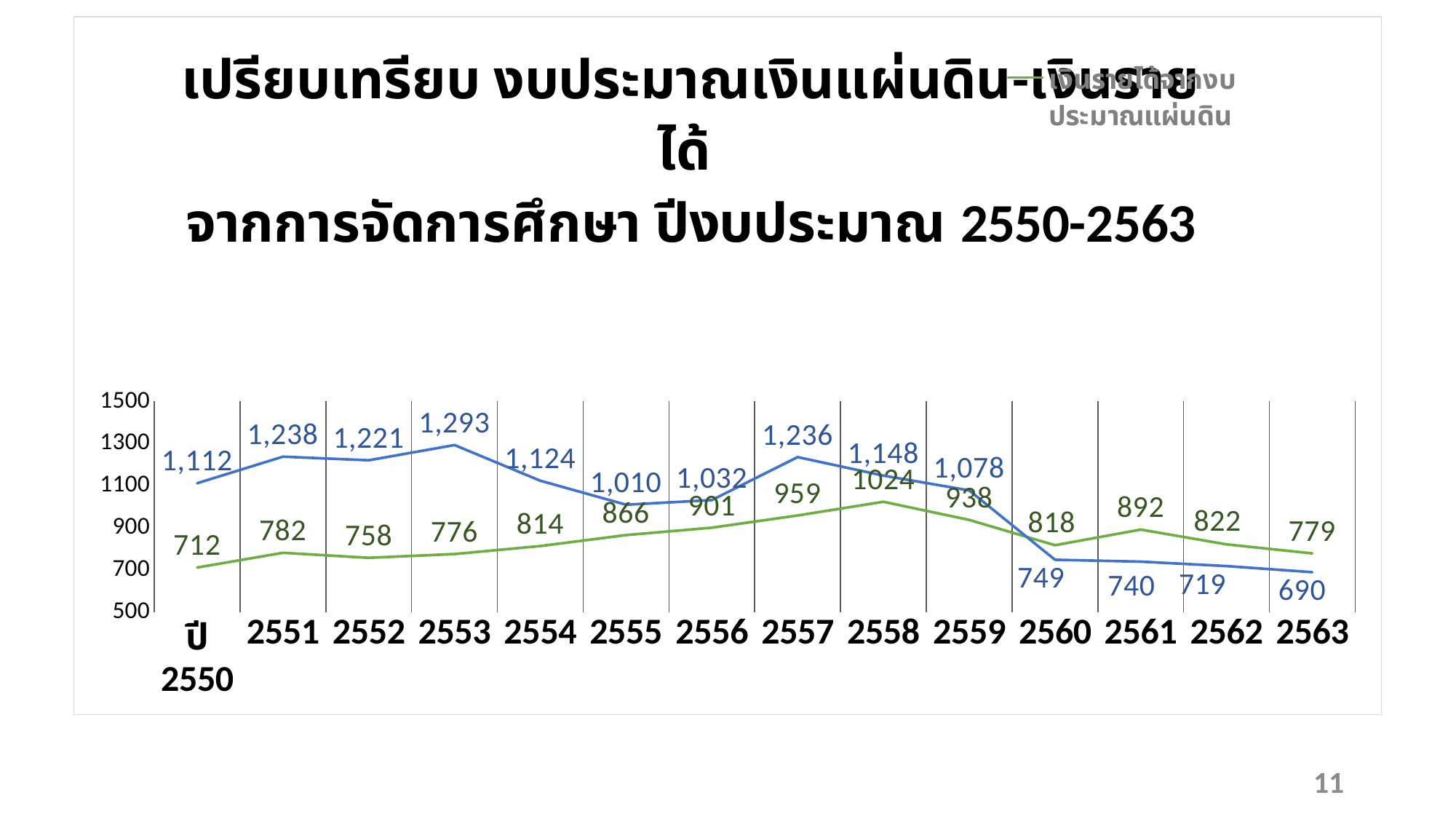
In which year does the blue line reach its lowest value? 2563 In year 2560, which line has the larger value, the blue line or the green line? green line How many years (data points) are plotted along the x axis? 14 In which year does the blue line reach its highest value? 2553 What is the difference between the green line's values in 2558 and 2559? 86 Does the blue line generally rise or fall from 2559 to 2563? fall What is the value of the blue line in year 2553? 1,293 What type of chart is shown on the slide? line chart In which year does the green line reach its lowest value? 2550 What is the value of the green line in year 2558? 1024 What is the difference between the blue line and the green line in year 2550? 400 What is the value of the blue line in year 2563? 690